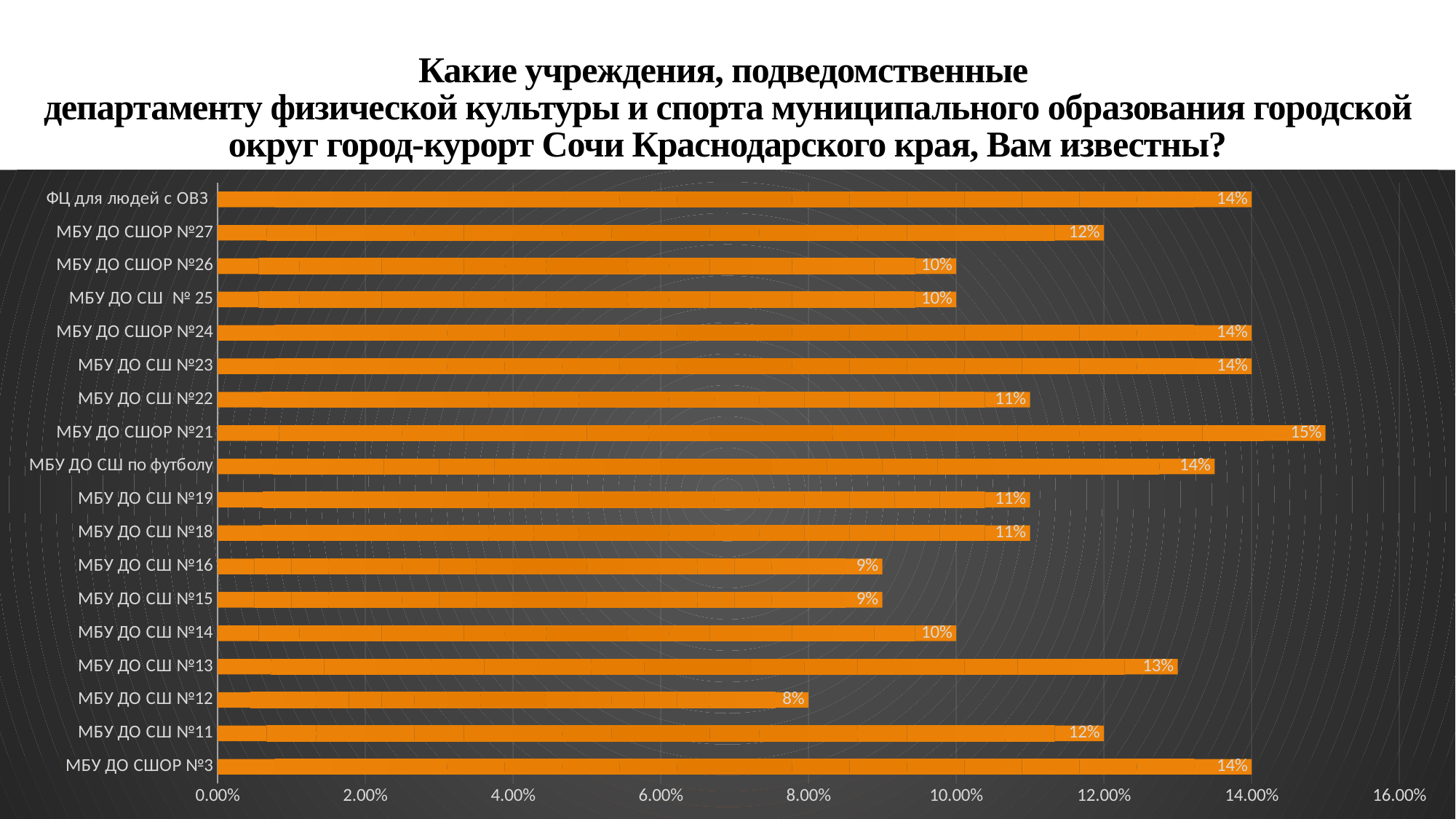
What kind of chart is shown on the slide? bar chart What is the value for ФЦ для людей с ОВЗ? 14% Which category has the lowest value? МБУ ДО СШ №12 Is the value for МБУ ДО СШ №12 greater or less than 10.00%? less What is the value for МБУ ДО СШ №12? 8% What is the value for МБУ ДО СШ №13? 13% What is the value for МБУ ДО СШОР №21? 15% What is the difference between the values for МБУ ДО СШОР №21 and МБУ ДО СШ №12? 7% Which category has the highest value? МБУ ДО СШОР №21 Which is larger, the value for МБУ ДО СШ №13 or the value for МБУ ДО СШ №11? МБУ ДО СШ №13 What colour are the bars in the chart? orange How many categories are shown in the chart? 18